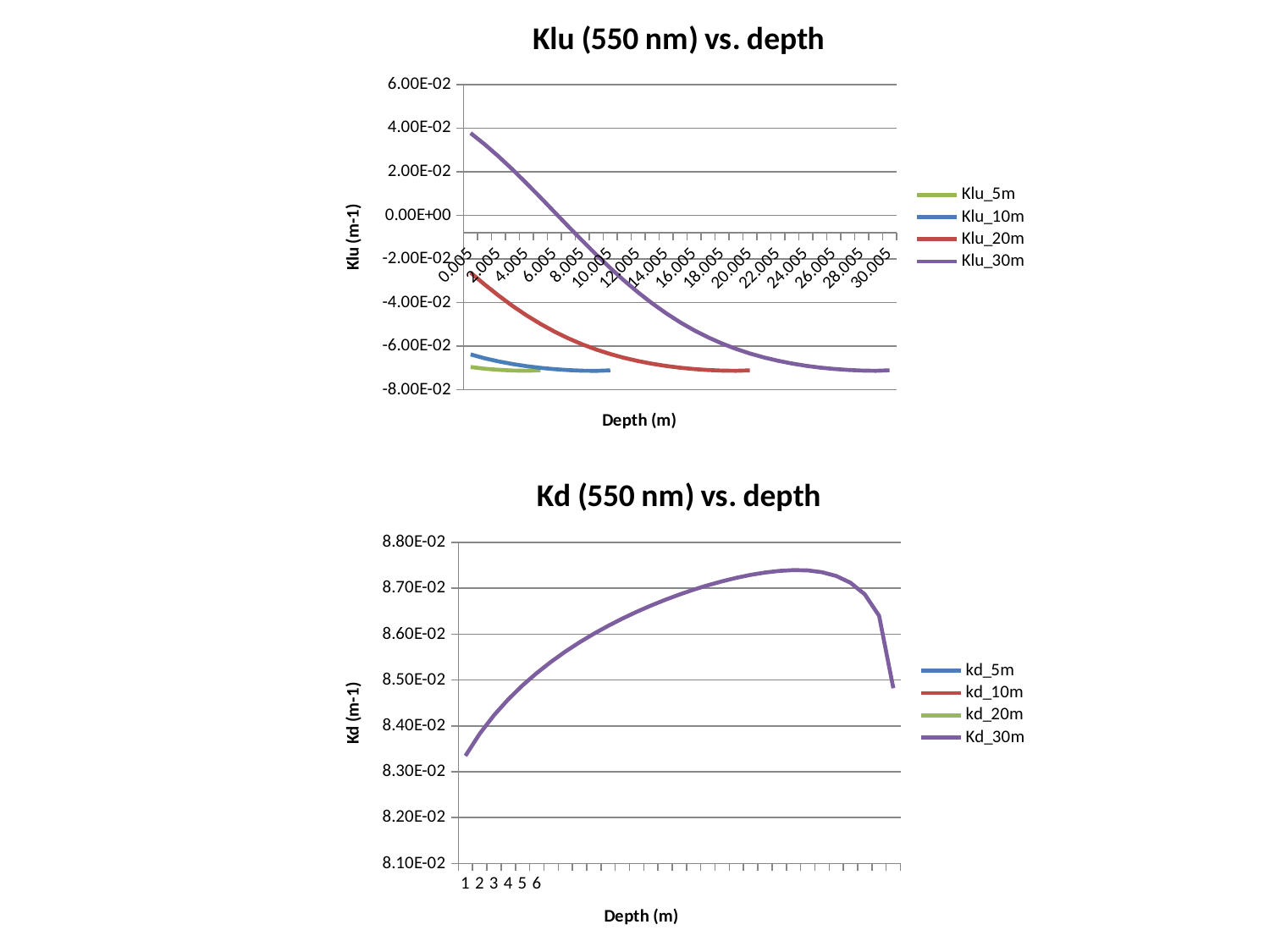
In the 'Kd (550 nm) vs. depth' chart, is the peak value of the Kd_30m series greater or less than 8.70E-02? greater In the 'Klu (550 nm) vs. depth' chart, is the value of Klu_30m at the shallowest depth greater or less than 2.00E-02? greater How many series does the legend of the 'Klu (550 nm) vs. depth' chart list? 4 In the 'Klu (550 nm) vs. depth' chart, is the value of Klu_20m at its shallowest depth greater or less than 0.00E+00? less What is the x-axis title of the 'Klu (550 nm) vs. depth' chart? Depth (m) In the 'Klu (550 nm) vs. depth' chart, does the Klu_30m series rise or fall as depth increases? fall In the 'Klu (550 nm) vs. depth' chart, which series reaches the greatest depth along the x axis? Klu_30m How many series does the legend of the 'Kd (550 nm) vs. depth' chart list? 4 In the 'Kd (550 nm) vs. depth' chart, does the Kd_30m series rise or fall over the first half of the depth range? rise What kind of chart is the 'Kd (550 nm) vs. depth' chart? line chart What kind of chart is the 'Klu (550 nm) vs. depth' chart? line chart